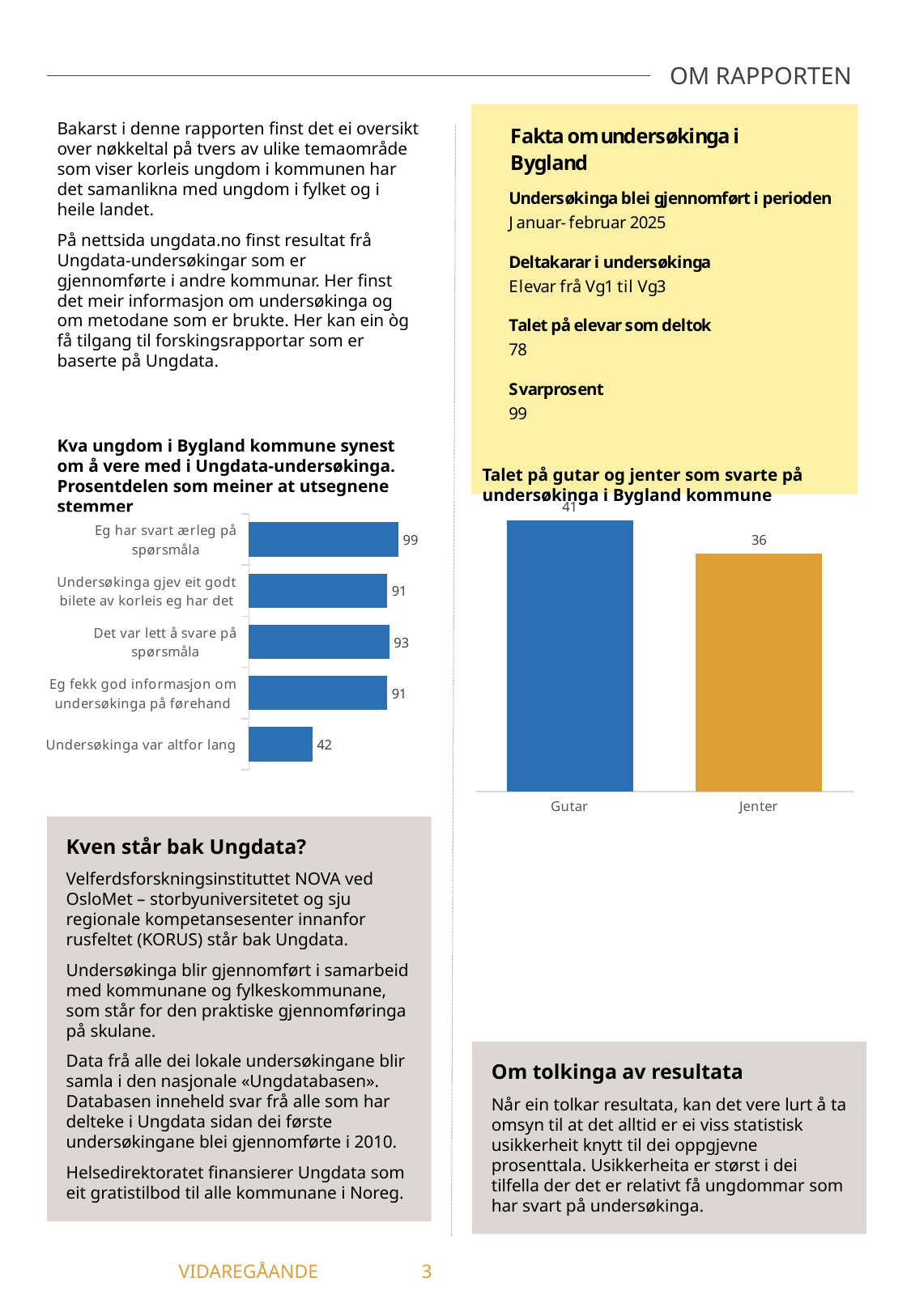
In the chart "Talet på gutar og jenter som svarte på undersøkinga i Bygland kommune", what is the value for Gutar? 41 In the left chart about what youth in Bygland think of taking part in the Ungdata survey, how many statements are shown? 5 In the left chart about what youth in Bygland think of taking part in the Ungdata survey, what is the value for "Eg har svart ærleg på spørsmåla"? 99 What kind of chart is the left chart about what youth in Bygland think of taking part in the Ungdata survey? Bar chart In the left chart about what youth in Bygland think of taking part in the Ungdata survey, which statement has the lowest value? Undersøkinga var altfor lang In the chart "Talet på gutar og jenter som svarte på undersøkinga i Bygland kommune", which group has the larger value, Gutar or Jenter? Gutar In the chart "Talet på gutar og jenter som svarte på undersøkinga i Bygland kommune", what is the value for Jenter? 36 In the left chart about what youth in Bygland think of taking part in the Ungdata survey, which statement has the highest value? Eg har svart ærleg på spørsmåla In the left chart about what youth in Bygland think of taking part in the Ungdata survey, what is the difference between "Eg har svart ærleg på spørsmåla" and "Undersøkinga var altfor lang"? 57 In the left chart about what youth in Bygland think of taking part in the Ungdata survey, what is the value for "Undersøkinga var altfor lang"? 42 In the left chart about what youth in Bygland think of taking part in the Ungdata survey, what is the value for "Det var lett å svare på spørsmåla"? 93 In the chart "Talet på gutar og jenter som svarte på undersøkinga i Bygland kommune", what is the difference between Gutar and Jenter? 5